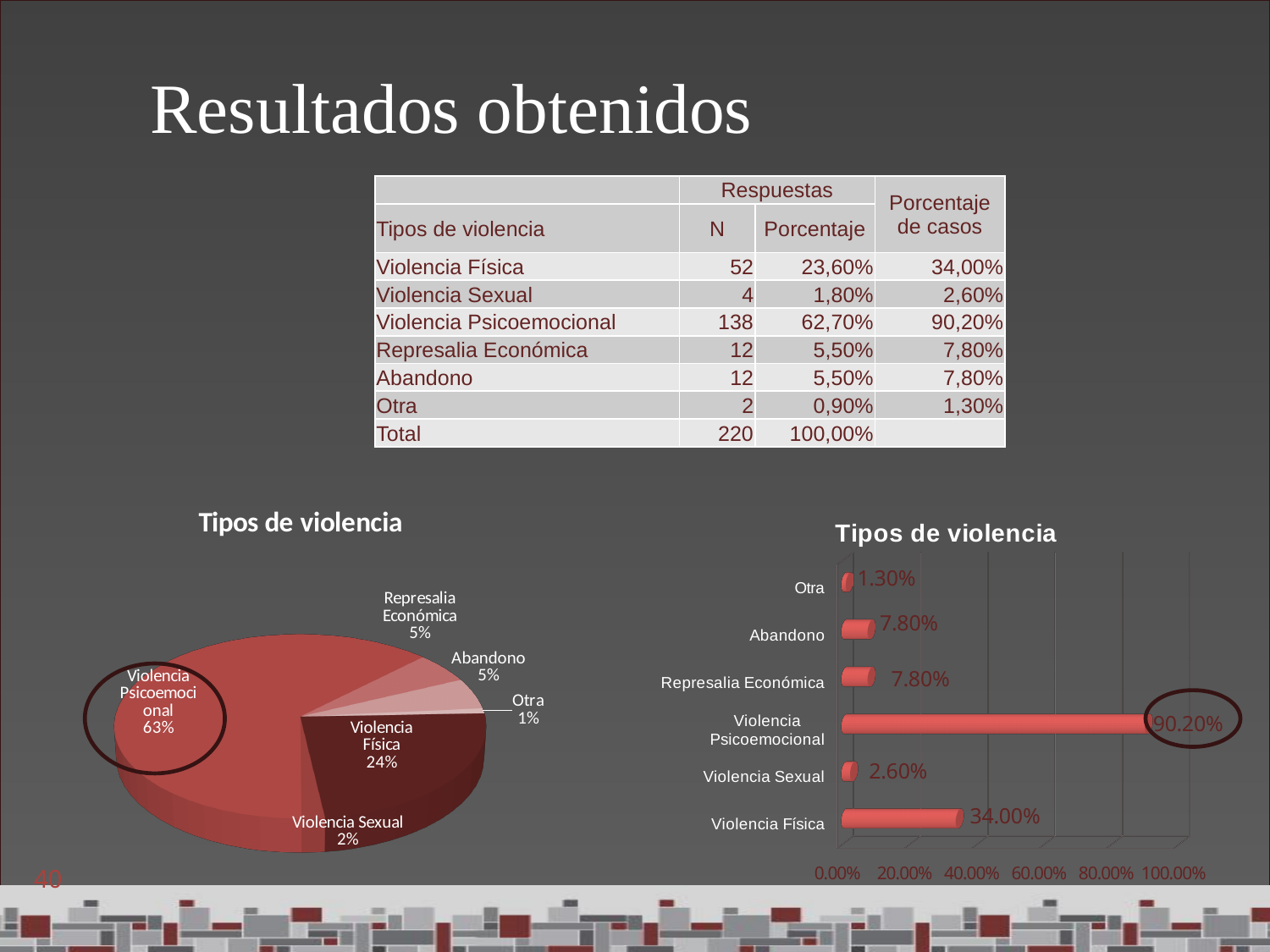
In the bar chart on the right, which is larger, the value for Violencia Sexual or the value for Abandono? Abandono In the bar chart on the right, what is the value for Violencia Psicoemocional? 90.20% In the bar chart on the right, which category has the highest value? Violencia Psicoemocional What kind of chart is the chart on the right of the slide? Bar chart In the bar chart on the right, what is the difference between the values for Violencia Psicoemocional and Violencia Física? 56.20% In the pie chart on the left, what share does Violencia Psicoemocional have? 63% What kind of chart is the chart on the left of the slide? Pie chart In the bar chart on the right, what is the value for Violencia Física? 34.00% In the bar chart on the right, what is the value for Otra? 1.30% How many categories are shown in the bar chart on the right? 6 In the bar chart on the right, which category has the lowest value? Otra In the pie chart on the left, what share does Violencia Física have? 24%